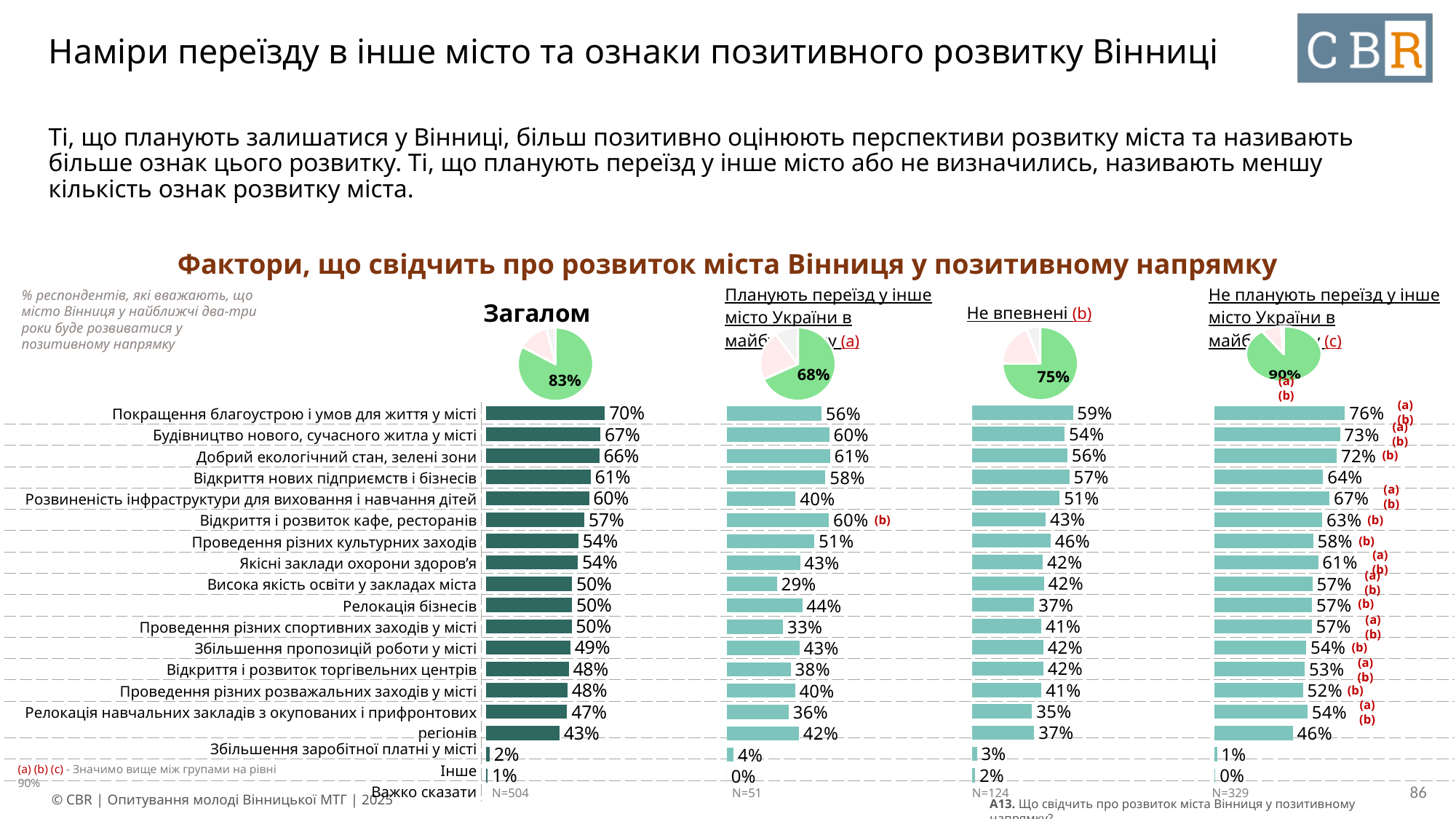
In the 'Загалом' chart, which category has the highest value? Покращення благоустрою і умов для життя у місті In the 'Не планують переїзд у інше місто України в майбутньому (c)' chart, what is the value for 'Добрий екологічний стан, зелені зони'? 72% In the 'Не впевнені (b)' chart, what is the value for 'Відкриття нових підприємств і бізнесів'? 57% How many respondent groups (bar chart columns) are shown on the slide? 4 For 'Розвиненість інфраструктури для виховання і навчання дітей', which group has the larger value: 'Планують переїзд' or 'Не впевнені'? Не впевнені In the pie chart for 'Не планують переїзд у інше місто України в майбутньому (c)', what share is shown? 90% What type of chart is used to show the factors of positive development for each group? Bar chart In the 'Планують переїзд у інше місто України в майбутньому (a)' chart, what is the value for 'Висока якість освіти у закладах міста'? 29% For 'Покращення благоустрою і умов для життя у місті', what is the difference between the 'Не планують переїзд' chart (76%) and the 'Загалом' chart (70%)? 6 percentage points In the 'Загалом' chart, what is the difference between 'Будівництво нового, сучасного житла у місті' (67%) and 'Добрий екологічний стан, зелені зони' (66%)? 1 percentage point In the 'Загалом' chart, what is the value for 'Покращення благоустрою і умов для життя у місті'? 70% In the 'Загалом' pie chart, what share of respondents believe Vinnytsia will develop positively in the next two-three years? 83%